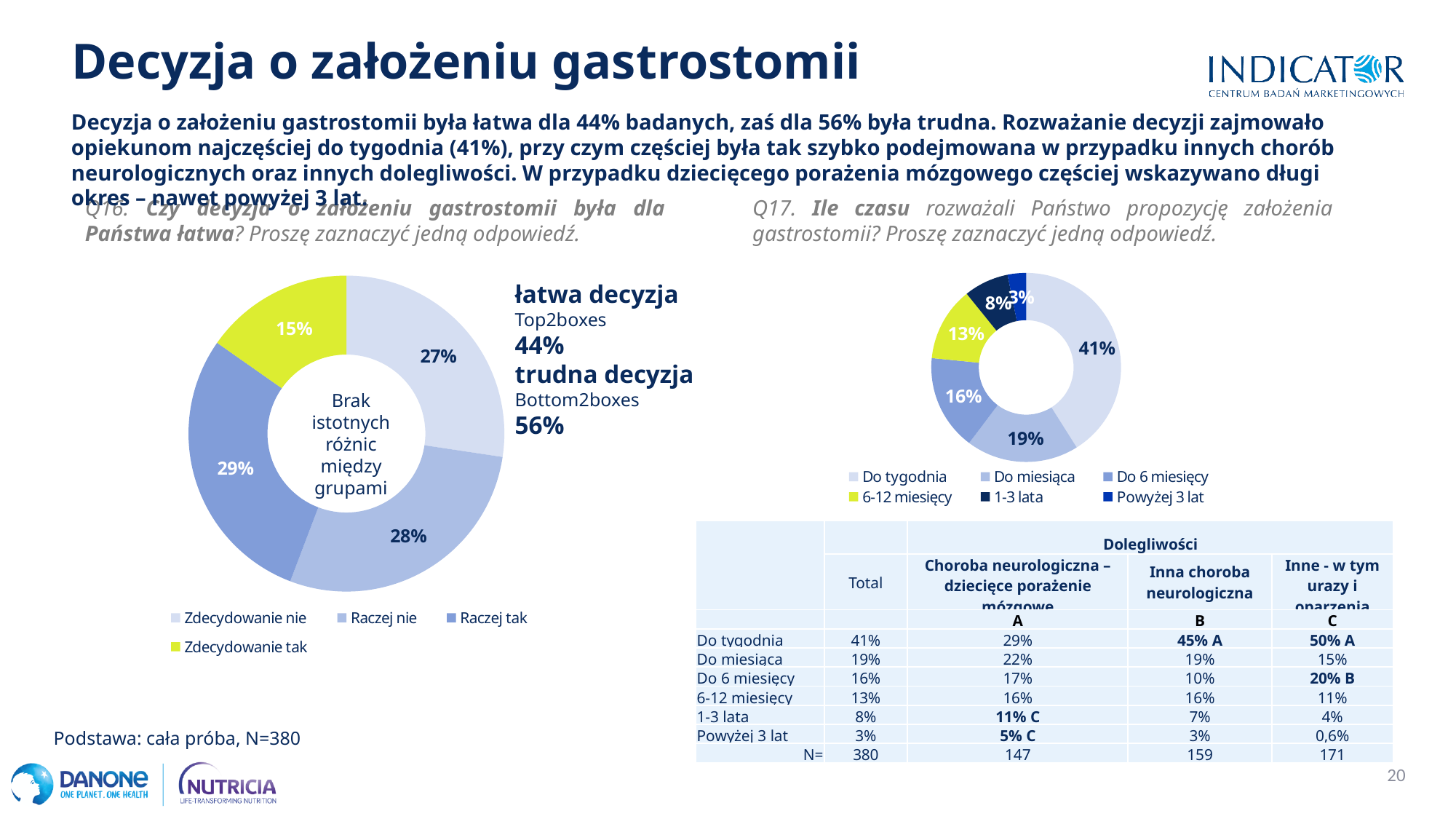
How many answer categories does the legend of the left donut chart (Q16) list? 4 In the right donut chart (Q17), what percentage of respondents chose "1-3 lata"? 8% In the right donut chart (Q17), what percentage of respondents chose "Do tygodnia"? 41% In the left donut chart (Q16), what percentage of respondents answered "Zdecydowanie nie"? 27% In the left donut chart (Q16), what is the difference between the shares for "Raczej tak" and "Zdecydowanie tak"? 14 percentage points In the right donut chart (Q17), which is larger: the share for "Do miesiąca" or for "Do 6 miesięcy"? Do miesiąca What type of chart is used for Q17 on the right side of the slide? Donut (pie) chart In the left donut chart (Q16), which answer category has the smallest share? Zdecydowanie tak How many categories does the legend of the right donut chart (Q17) list? 6 In the left donut chart (Q16), which answer category has the largest share? Raczej tak In the right donut chart (Q17), which category has the smallest share? Powyżej 3 lat In the left donut chart (Q16), what percentage of respondents answered "Zdecydowanie tak"? 15%